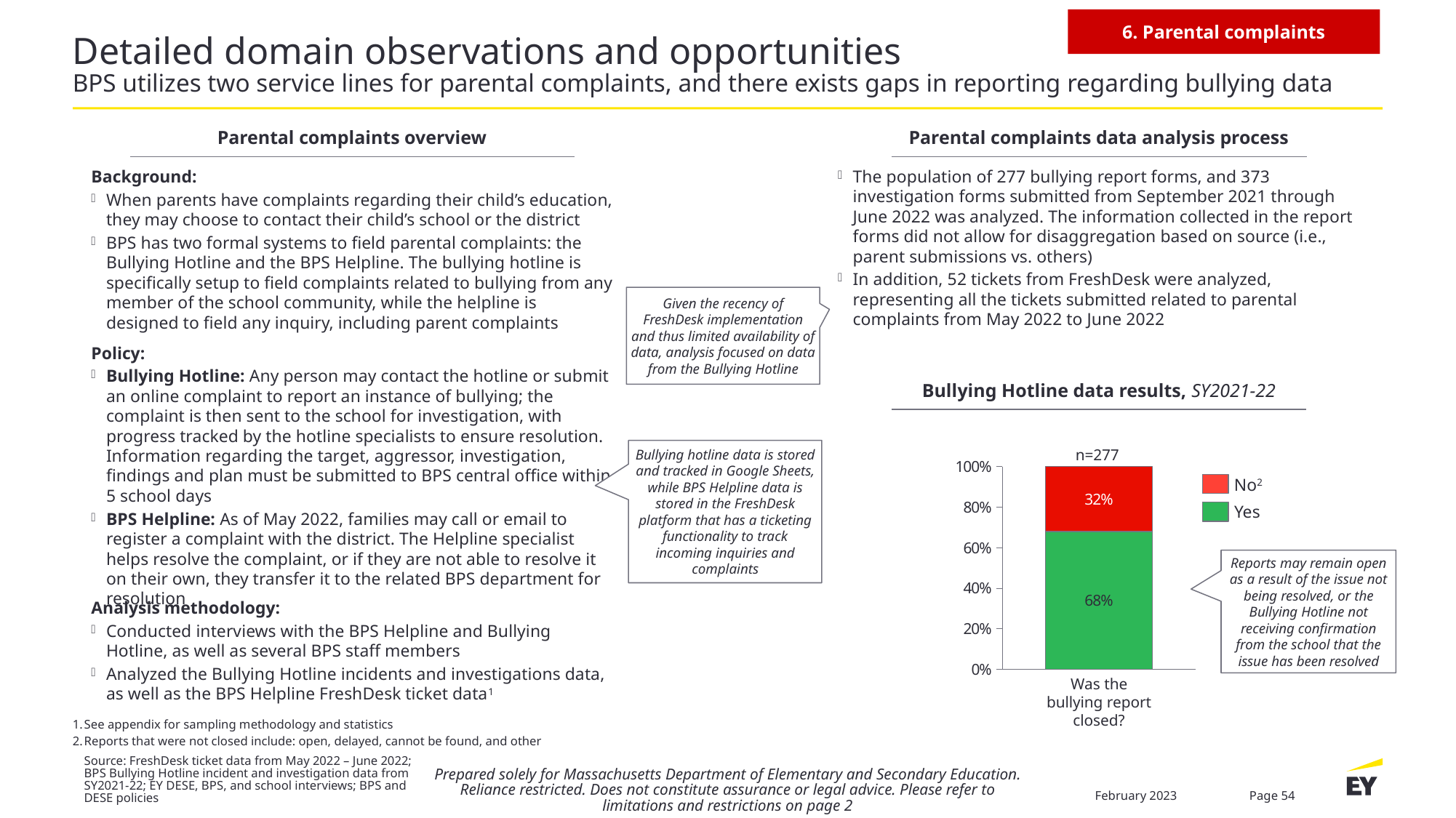
What is the sample size (n) shown above the bar in the Bullying Hotline data results chart? n=277 How many series does the legend of the Bullying Hotline data results chart list? 2 Which segment is larger in the stacked bar, Yes or No? Yes What is the difference in percentage points between the Yes and No segments of the bar? 36 What is the total of the stacked bar when the Yes and No segments are added together? 100% What percentage of bullying reports were not closed (No) in the Bullying Hotline data results chart? 32% What percentage of bullying reports were closed (Yes) in the Bullying Hotline data results chart? 68% What colour represents the Yes series in the chart? Green How many bars are plotted in the Bullying Hotline data results chart? 1 Is the Yes segment of the bar greater or less than 60%? greater What kind of chart is used to show the Bullying Hotline data results? Stacked bar chart What is the category label on the x axis of the Bullying Hotline data results chart? Was the bullying report closed?